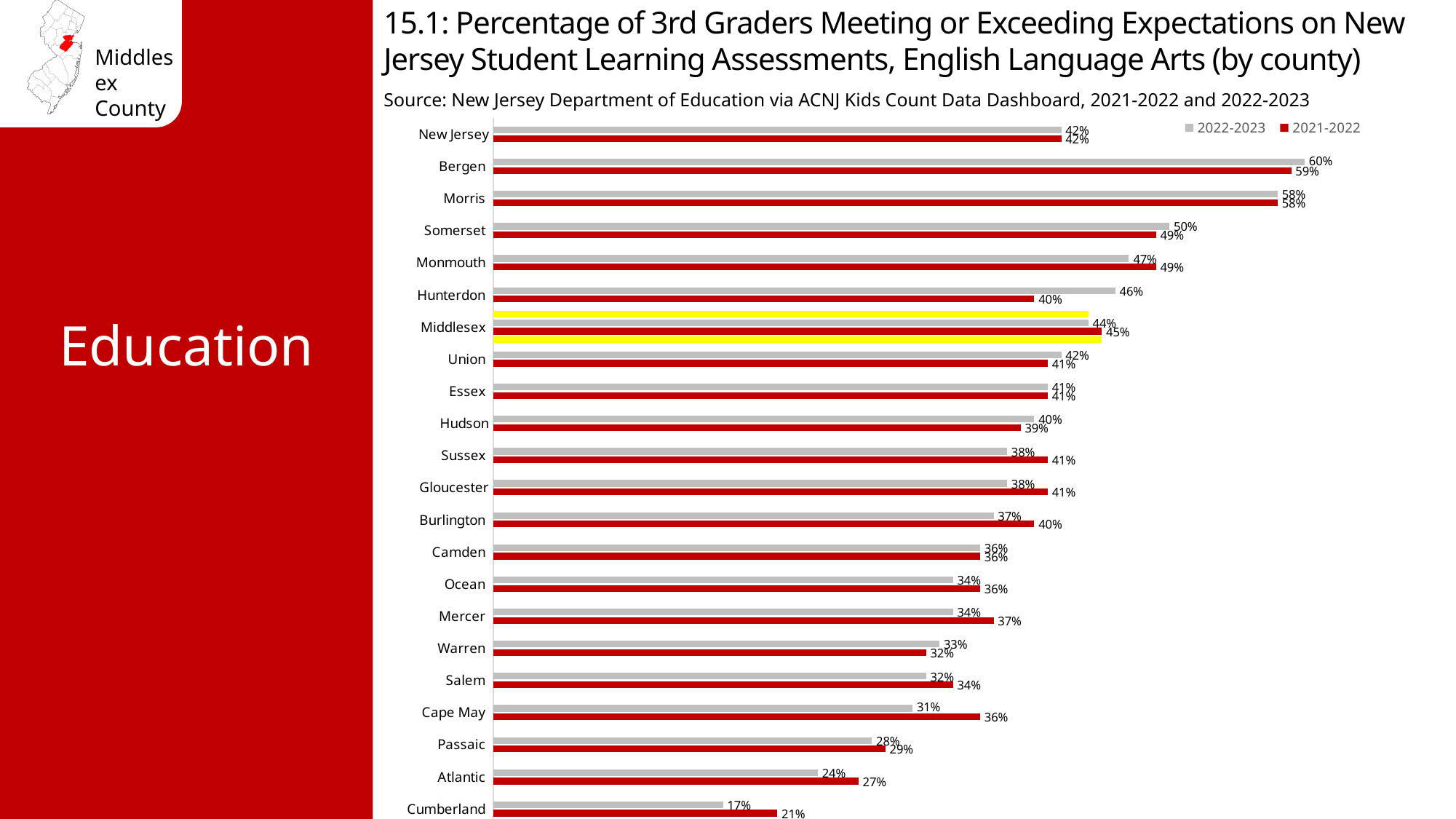
What kind of chart is shown on the slide? Bar chart What is the difference between the 2021-2022 values for Bergen and Cumberland? 38% What is the difference between the 2022-2023 and 2021-2022 values for Hunterdon? 6% How many series does the legend list? 2 What is the 2022-2023 value for Cape May? 31% How many counties or regions are listed on the chart? 22 Which is larger for Monmouth, the 2022-2023 value or the 2021-2022 value? 2021-2022 Which county has the lowest 2021-2022 value? Cumberland What is the 2022-2023 value for Middlesex? 44% Which county is highlighted in yellow on the chart? Middlesex Which county has the highest 2022-2023 value? Bergen What is the 2021-2022 value for Hunterdon? 40%